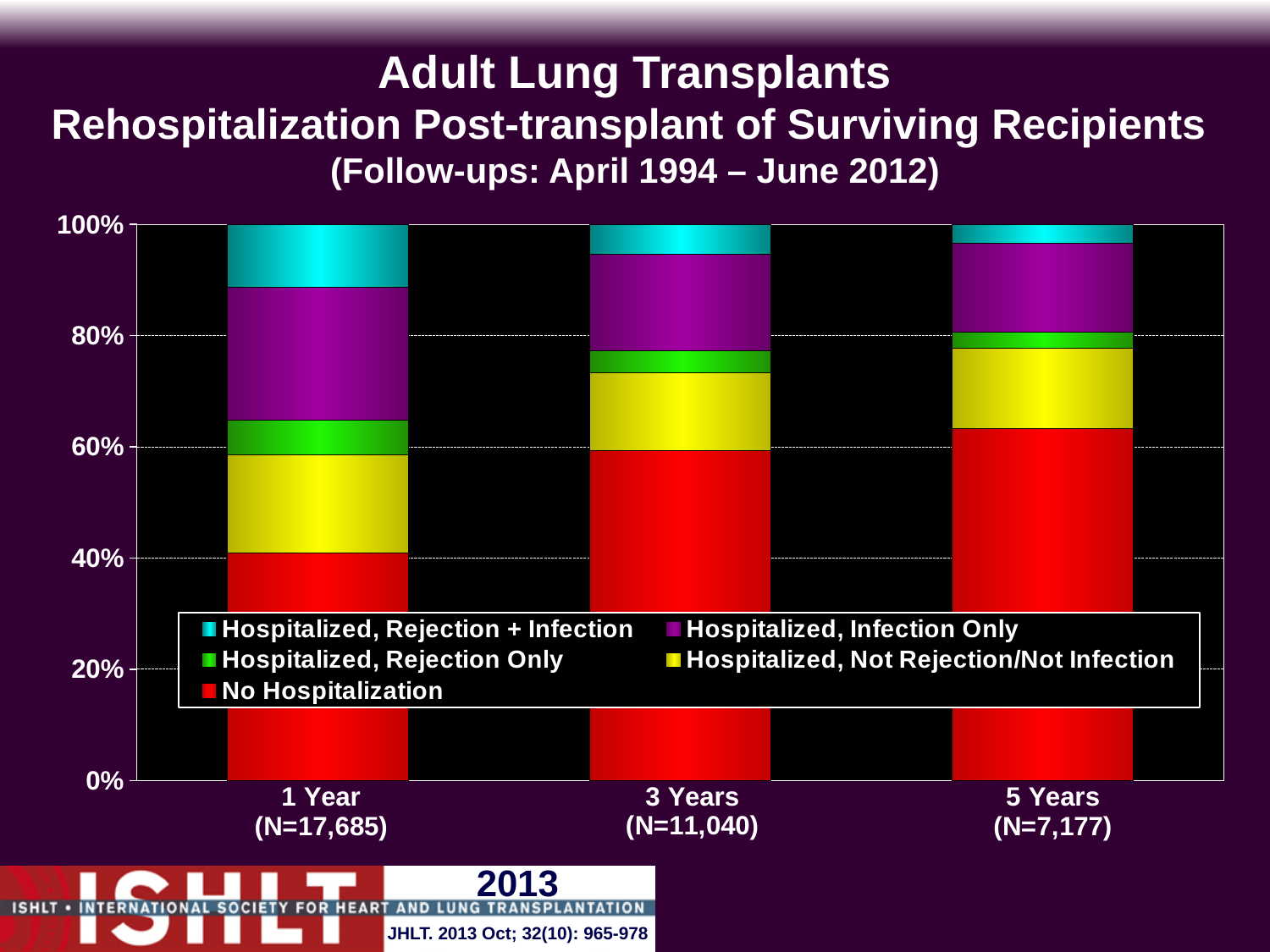
What is the total height of each stacked bar? 100% Is the No Hospitalization share at 1 Year greater or less than 60%? less How many time-point categories are shown on the x axis? 3 Does the Hospitalized, Rejection + Infection share rise or fall from 1 Year to 5 Years? fall At which time point is the No Hospitalization share the largest? 5 Years What kind of chart is shown on the slide? Stacked bar chart At which time point is the No Hospitalization share the smallest? 1 Year How many series does the legend list? 5 Is the No Hospitalization share at 5 Years greater or less than 40%? greater Which has a larger No Hospitalization share, 1 Year or 3 Years? 3 Years What is the N shown for the 1 Year category? N=17,685 Does the No Hospitalization share rise or fall from 1 Year to 5 Years? rise